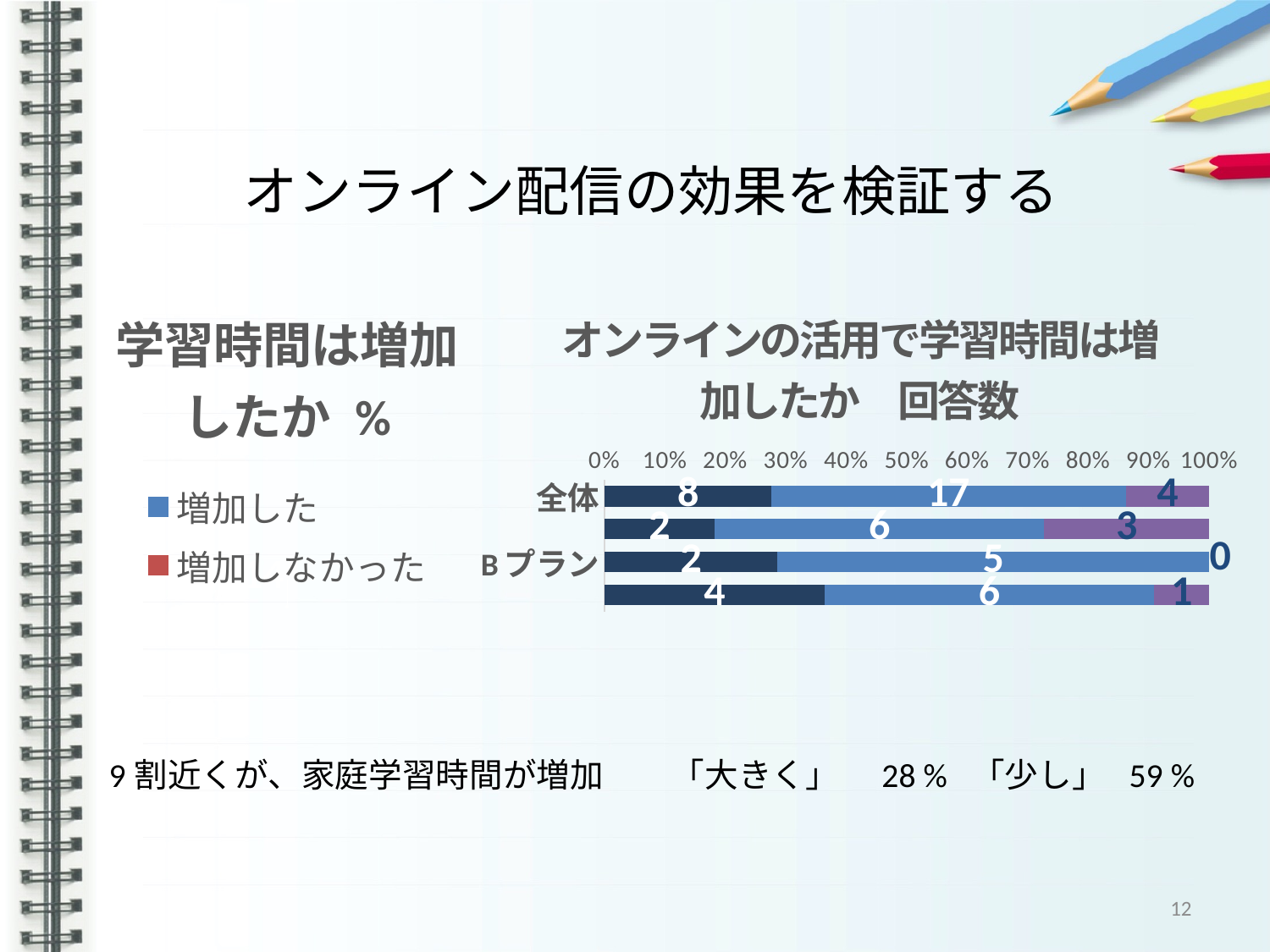
In the chart titled 「オンラインの活用で学習時間は増加したか 回答数」, which segment of the 全体 bar has the largest value? the middle (blue) segment, 17 In the chart titled 「オンラインの活用で学習時間は増加したか 回答数」, how many bars are plotted? 4 In the chart titled 「オンラインの活用で学習時間は増加したか 回答数」, what is the difference between the middle (blue) segment and the first (dark navy) segment of the 全体 bar? 9 In the chart titled 「オンラインの活用で学習時間は増加したか 回答数」, what is the value of the last (purple) segment of the 全体 bar? 4 In the chart titled 「オンラインの活用で学習時間は増加したか 回答数」, what is the value of the middle (blue) segment of the Bプラン bar? 5 In the chart titled 「オンラインの活用で学習時間は増加したか 回答数」, what is the total of the three segments of the 全体 bar? 29 In the chart titled 「オンラインの活用で学習時間は増加したか 回答数」, what is the value of the middle (blue) segment of the 全体 bar? 17 In the chart titled 「オンラインの活用で学習時間は増加したか 回答数」, what is the value of the first (dark navy) segment of the 全体 bar? 8 In the chart titled 「オンラインの活用で学習時間は増加したか 回答数」, is the first (dark navy) segment or the middle (blue) segment of the 全体 bar larger? the middle (blue) segment In the chart titled 「オンラインの活用で学習時間は増加したか 回答数」, what is the total of the segments of the Bプラン bar? 7 What kind of chart is the chart titled 「オンラインの活用で学習時間は増加したか 回答数」? bar chart How many entries does the legend of the chart titled 「学習時間は増加したか %」 list? 2